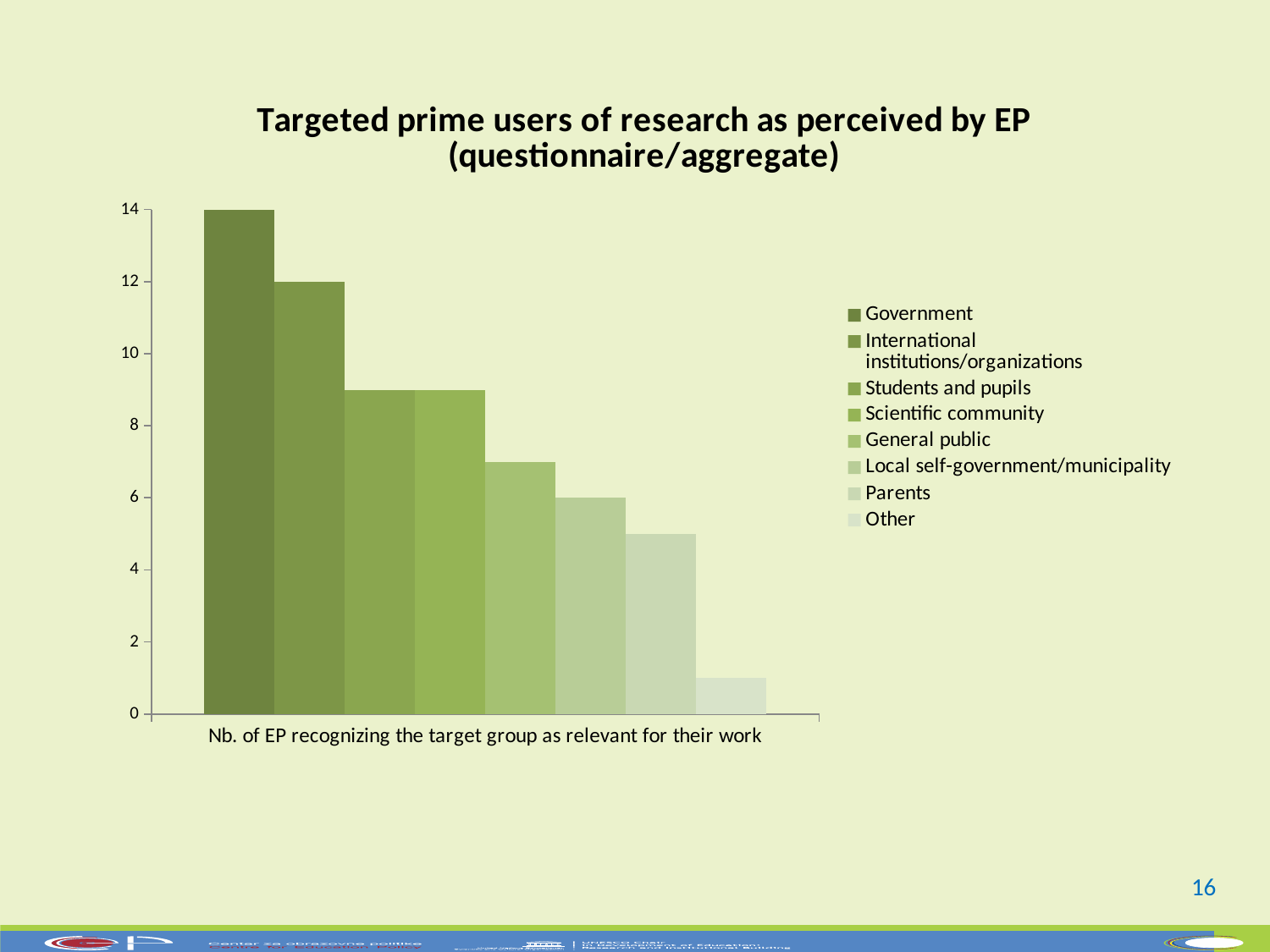
What type of chart is shown on the slide? Bar chart Which series has the lowest value? Other Is the value for General public greater or less than 8? less What is the difference between the values for Government and International institutions/organizations? 2 What is the value for International institutions/organizations? 12 Is the value for Students and pupils greater or less than 8? greater Which is larger, the value for Scientific community or the value for Parents? Scientific community How many series does the legend list? 8 What is the title of the chart? Targeted prime users of research as perceived by EP (questionnaire/aggregate) What is the value for Local self-government/municipality? 6 Which series has the highest value? Government What is the value for Government? 14